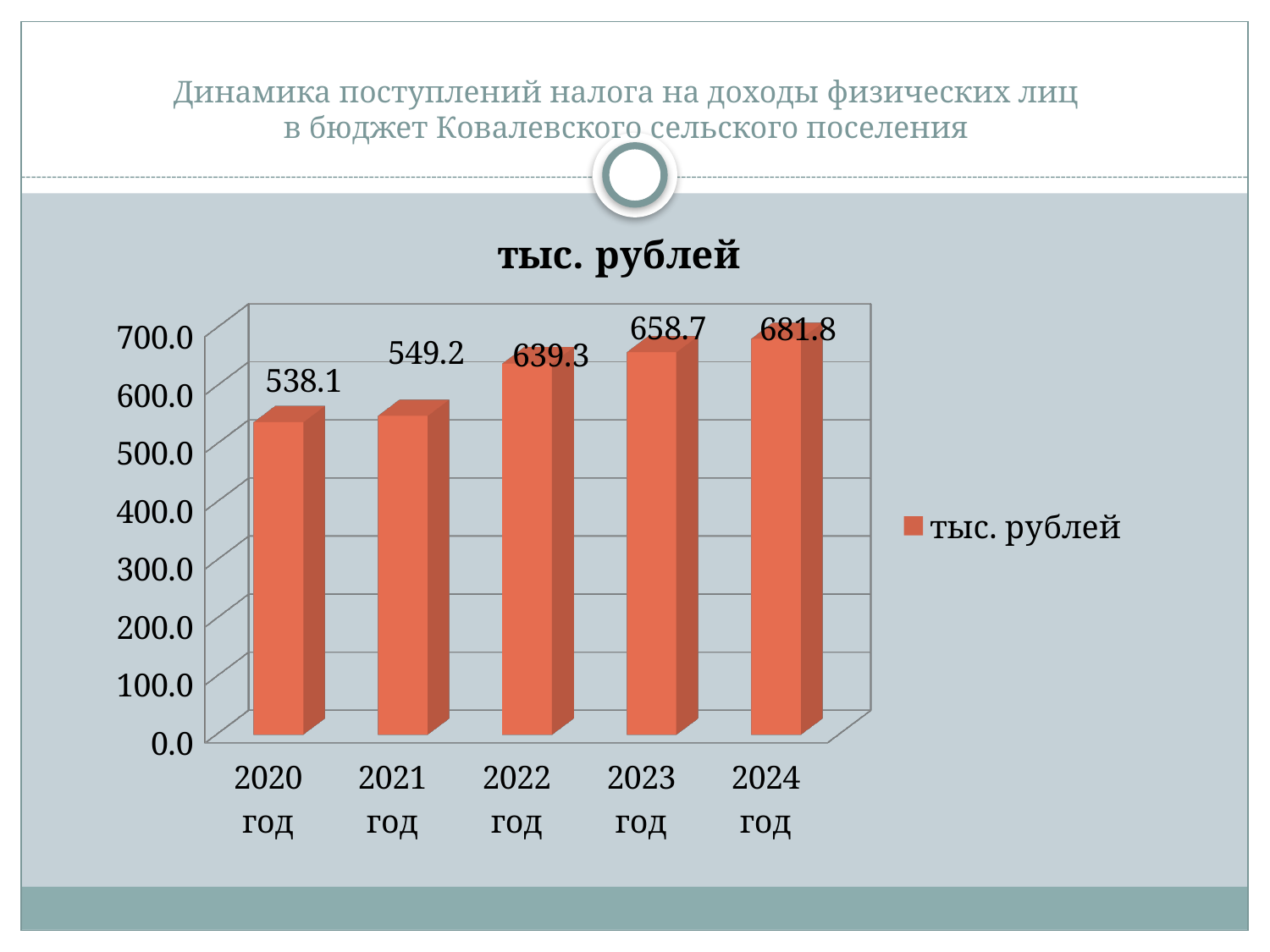
What is the value for 2022 год? 639.3 Is the value for 2021 год greater or less than 600.0? less Do the values rise or fall from 2020 год to 2024 год? rise What is the difference between the values for 2023 год and 2022 год? 19.4 What is the value for 2024 год? 681.8 What is the difference between the values for 2024 год and 2020 год? 143.7 Which year has the lowest value? 2020 год What is the value for 2020 год? 538.1 Which year has the highest value? 2024 год How many years are shown on the x axis? 5 Which is larger, the value for 2021 год or the value for 2023 год? 2023 год What kind of chart is shown on the slide? bar chart